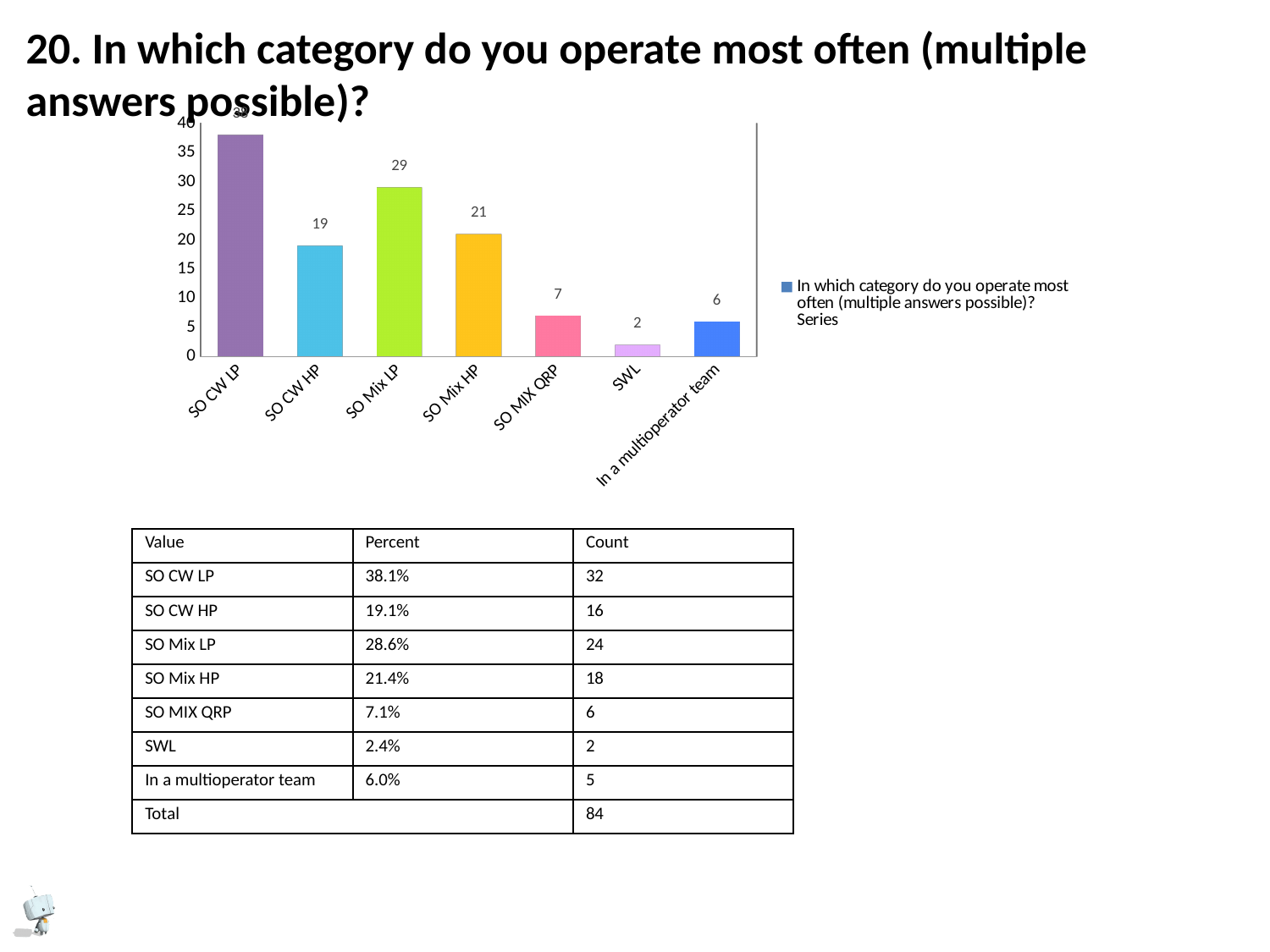
Which category has the lowest bar in the chart? SWL What is the value plotted for SO MIX QRP in the chart? 7 Which category has the highest bar in the chart? SO CW LP What is the difference between the values for SO Mix LP and SO Mix HP in the chart? 8 What is the value plotted for In a multioperator team in the chart? 6 What is the value plotted for SO CW HP in the chart? 19 Which is larger in the chart, the value for SO CW HP or the value for SO Mix HP? SO Mix HP What is the value plotted for SWL in the chart? 2 How many categories are plotted on the x axis of the chart? 7 What is the value plotted for SO Mix HP in the chart? 21 What type of chart is shown on the slide? bar chart What is the value plotted for SO Mix LP in the chart? 29